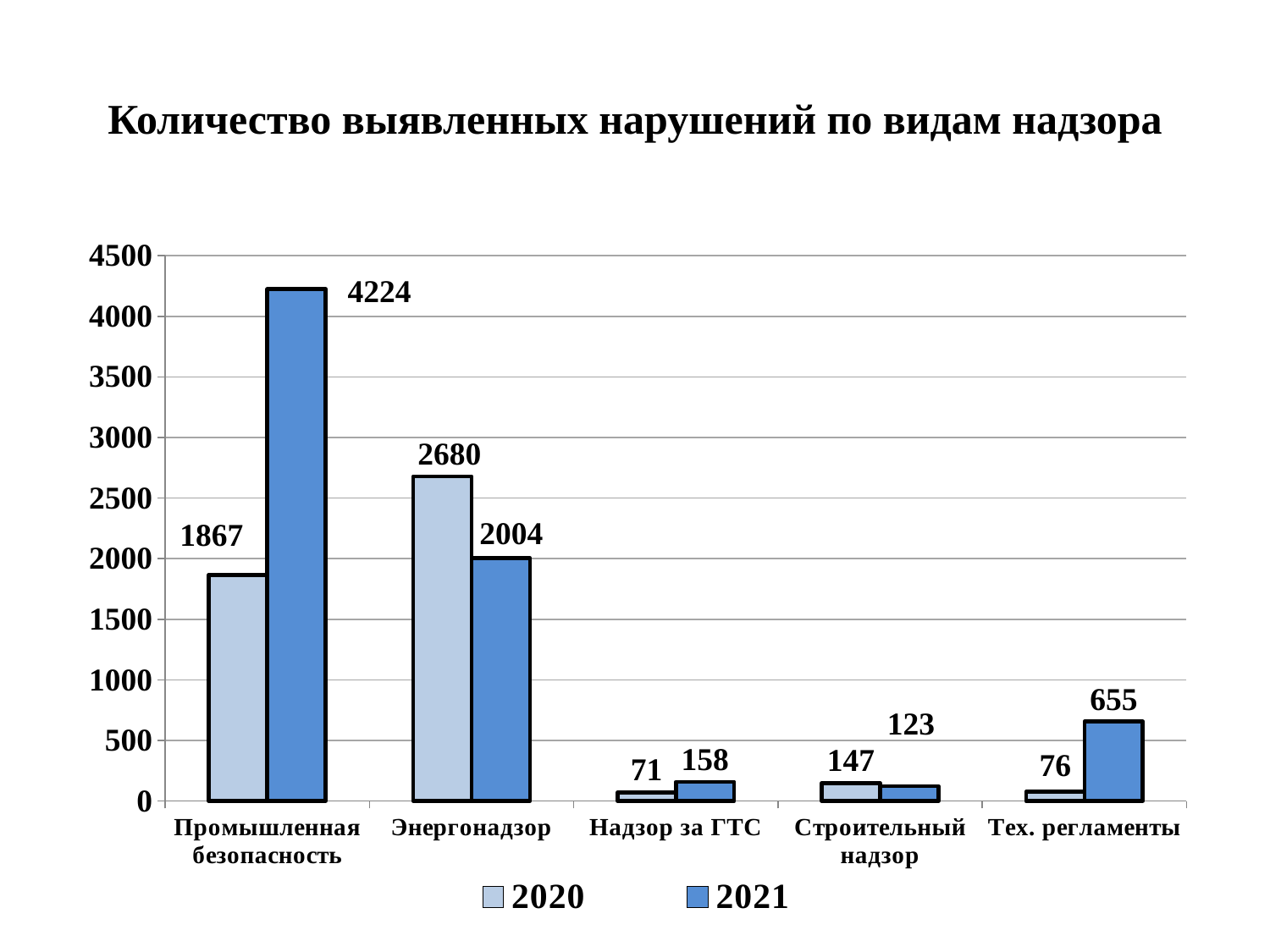
What is the value for Тех. регламенты in 2021? 655 What is the title of the chart? Количество выявленных нарушений по видам надзора What kind of chart is shown on the slide? Bar chart How many series does the legend list? 2 What is the difference between the 2021 and 2020 values for Промышленная безопасность? 2357 Is the value for Тех. регламенты in 2021 greater or less than 500? greater How many categories are shown on the x axis? 5 Which is larger for Энергонадзор: the 2020 value or the 2021 value? 2020 Which category has the lowest value in 2021? Строительный надзор What is the value for Промышленная безопасность in 2021? 4224 What is the value for Энергонадзор in 2020? 2680 Which category has the highest value in 2020? Энергонадзор